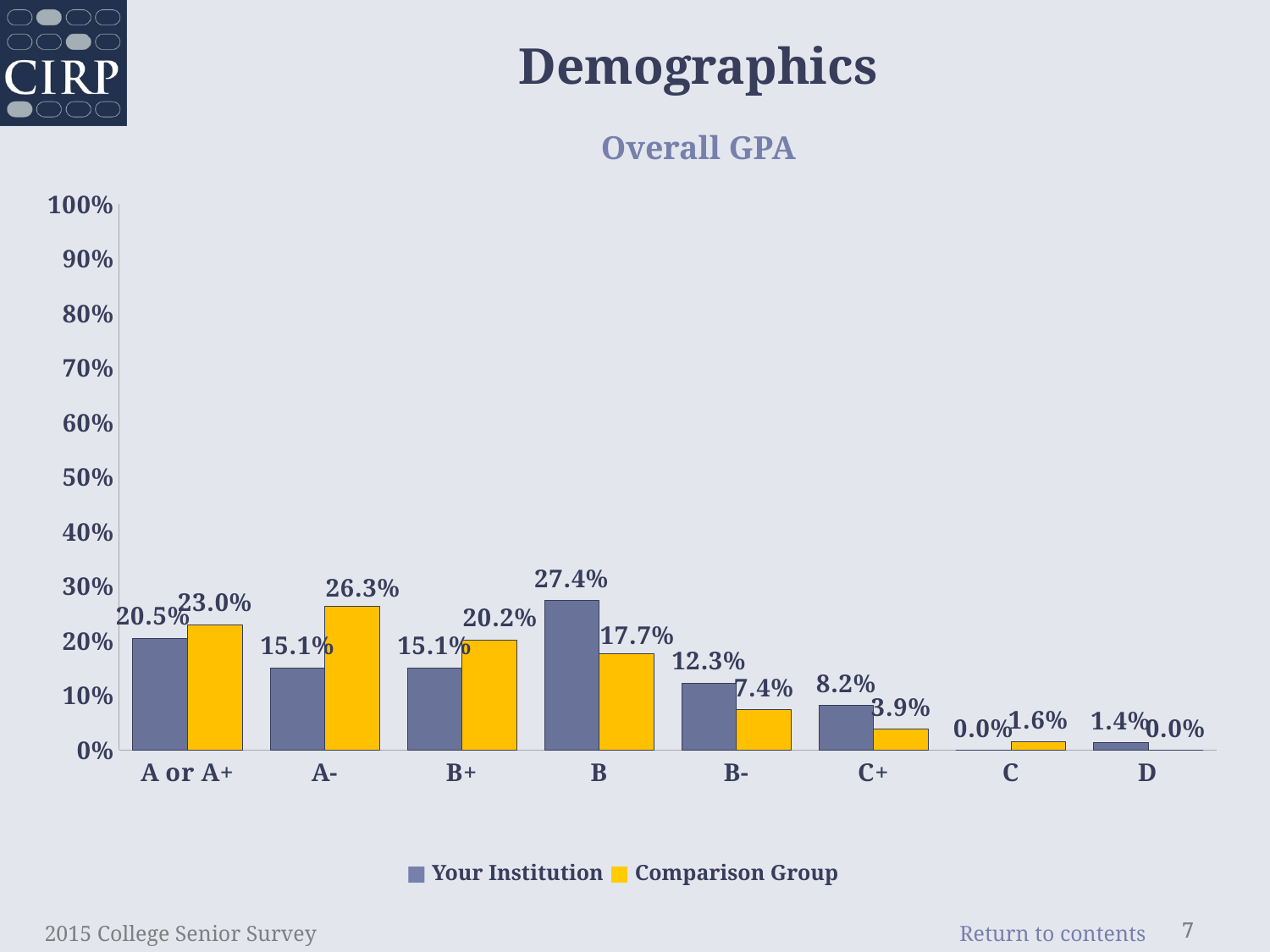
What kind of chart is shown on the slide? bar chart What is the value for the Comparison Group in the C category? 1.6% What is the value for Your Institution in the B category? 27.4% Is the value for Your Institution in the B- category greater or less than 10%? greater What is the value for the Comparison Group in the A- category? 26.3% How many series does the legend list? 2 Which GPA category has the lowest value for the Comparison Group? D Which GPA category has the highest value for Your Institution? B What is the difference between Your Institution and the Comparison Group in the B category? 9.7% Which is larger in the A- category, Your Institution or the Comparison Group? Comparison Group What is the title of the chart? Overall GPA How many GPA categories are shown on the x axis? 8